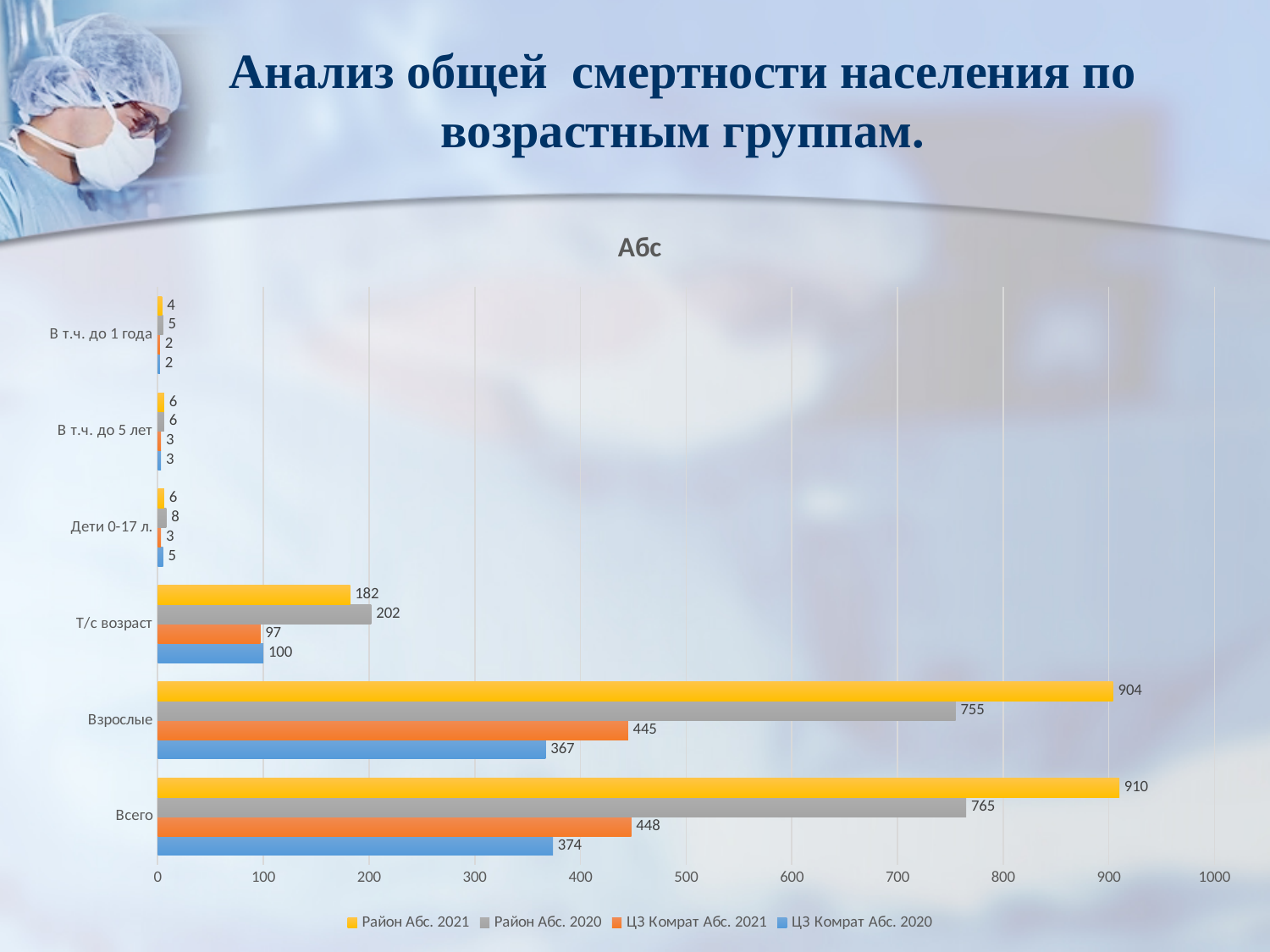
Which is larger for Т/с возраст: the Район Абс. 2021 value or the Район Абс. 2020 value? Район Абс. 2020 What is the difference between the ЦЗ Комрат Абс. 2021 and ЦЗ Комрат Абс. 2020 values for Всего? 74 What is the value for Т/с возраст in the Район Абс. 2020 series? 202 How many series does the legend list? 4 What kind of chart is shown on the slide? Bar chart How many categories are shown on the chart? 6 Which category has the highest value in the Район Абс. 2021 series? Всего What is the title of the chart? Абс What is the value for Дети 0-17 л. in the ЦЗ Комрат Абс. 2021 series? 3 What is the value for Всего in the Район Абс. 2021 series? 910 What is the difference between the Район Абс. 2021 and Район Абс. 2020 values for Взрослые? 149 What is the value for Взрослые in the ЦЗ Комрат Абс. 2020 series? 367